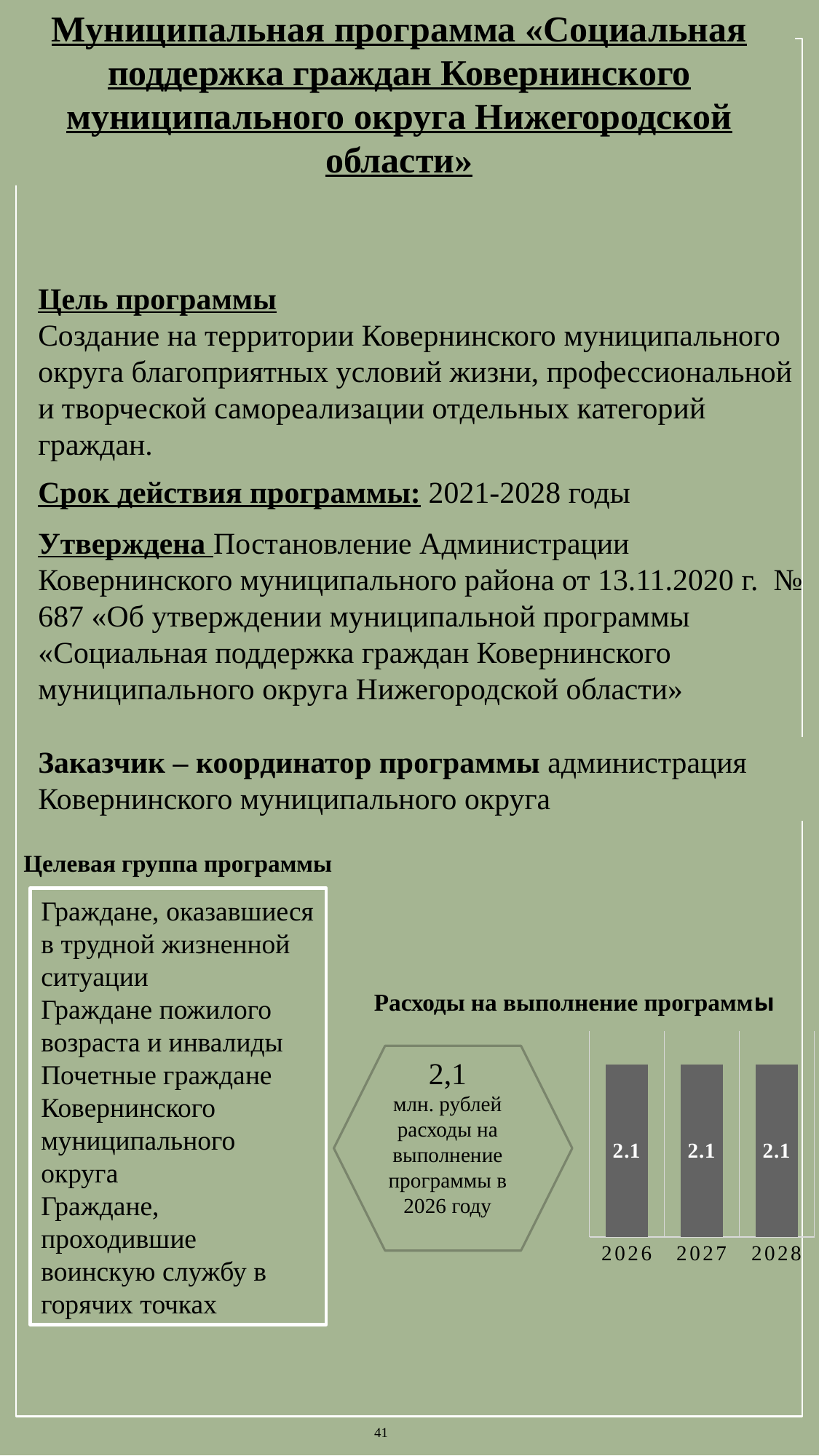
What kind of chart is "Расходы на выполнение программы"? bar chart What is the value for 2027 in the chart "Расходы на выполнение программы"? 2.1 What is the difference between the values for 2028 and 2026 in the chart "Расходы на выполнение программы"? 0 How many years (categories) are shown in the chart "Расходы на выполнение программы"? 3 What is the value for 2026 in the chart "Расходы на выполнение программы"? 2.1 What is the title of the bar chart on the slide? Расходы на выполнение программы What is the value for 2028 in the chart "Расходы на выполнение программы"? 2.1 Do the values in the chart "Расходы на выполнение программы" rise, fall, or stay the same from 2026 to 2028? stay the same Which year is the first category on the x axis of the chart "Расходы на выполнение программы"? 2026